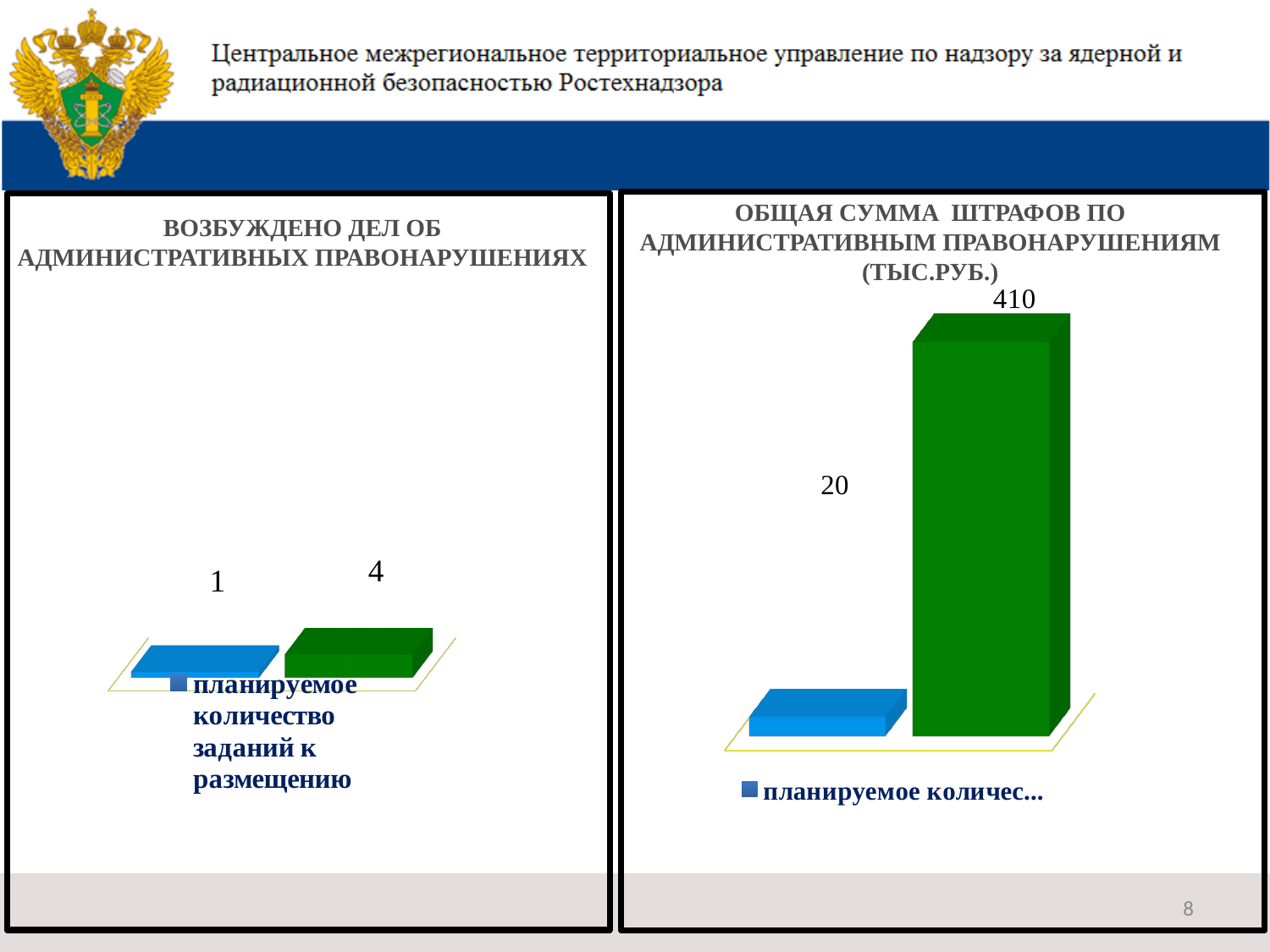
In the left chart, which bar is taller, the blue one or the green one? the green one In the left chart titled 'ВОЗБУЖДЕНО ДЕЛ ОБ АДМИНИСТРАТИВНЫХ ПРАВОНАРУШЕНИЯХ', what value is shown on the blue bar? 1 In the right chart titled 'ОБЩАЯ СУММА ШТРАФОВ ПО АДМИНИСТРАТИВНЫМ ПРАВОНАРУШЕНИЯМ (ТЫС.РУБ.)', what value is shown on the blue bar? 20 How many bars are plotted in the left chart? 2 How many bars are plotted in the right chart? 2 In the right chart, which bar has the highest value? the green bar (410) In the right chart titled 'ОБЩАЯ СУММА ШТРАФОВ ПО АДМИНИСТРАТИВНЫМ ПРАВОНАРУШЕНИЯМ (ТЫС.РУБ.)', what value is shown on the green bar? 410 What unit is given in parentheses in the title of the right chart? ТЫС.РУБ. What type of chart is the right chart on the slide? bar chart In the right chart, what is the difference between the green bar's value and the blue bar's value? 390 In the left chart, what is the difference between the green bar's value and the blue bar's value? 3 In the left chart titled 'ВОЗБУЖДЕНО ДЕЛ ОБ АДМИНИСТРАТИВНЫХ ПРАВОНАРУШЕНИЯХ', what value is shown on the green bar? 4